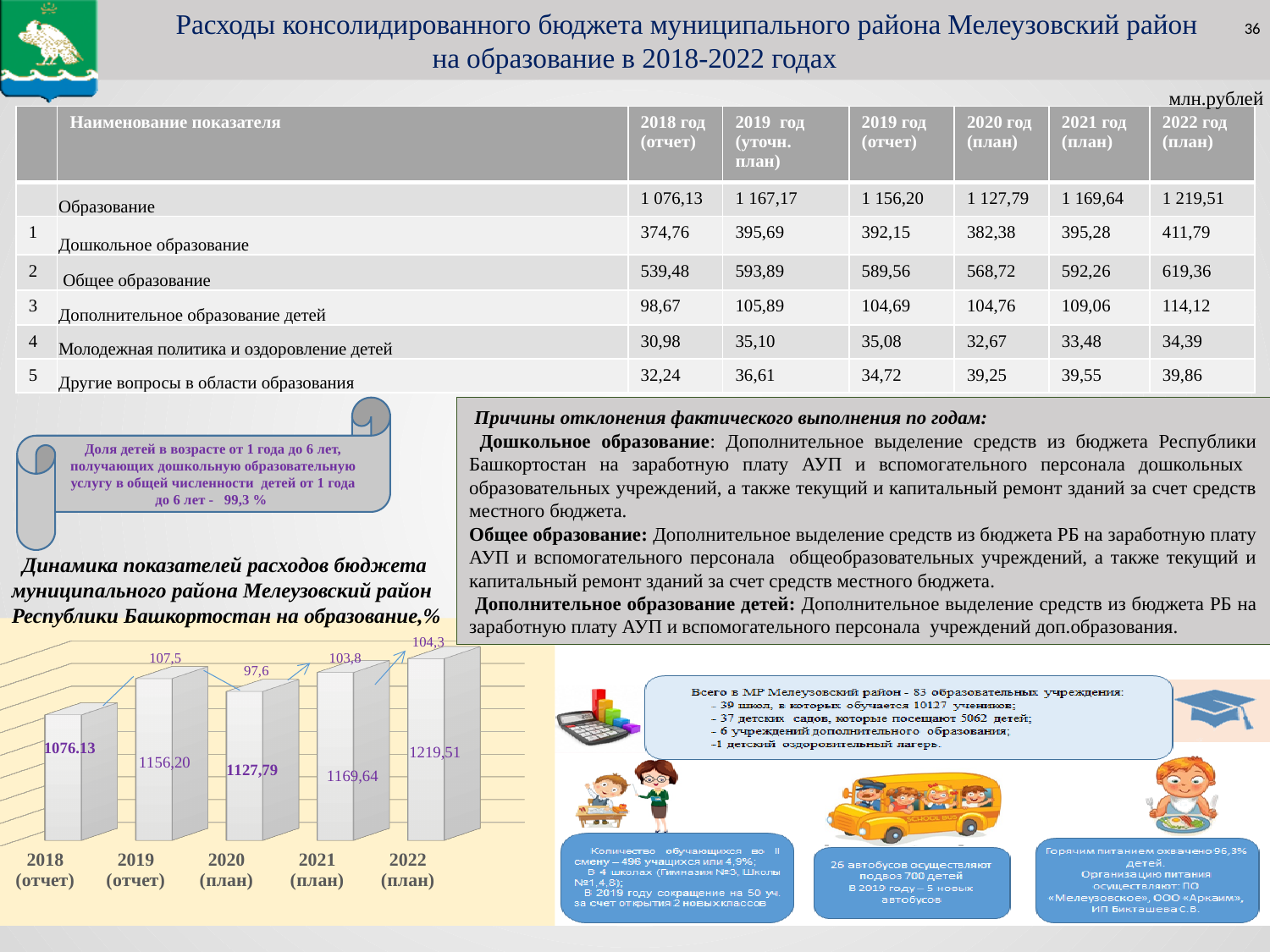
In the bar chart at the bottom left, what is the value for 2020 (план)? 1127,79 In the bar chart at the bottom left, which year has the highest value? 2022 (план) What type of chart is shown at the bottom left of the slide? bar chart In the bar chart at the bottom left, does the value rise or fall from 2019 (отчет) to 2020 (план)? fall In the bar chart at the bottom left, what is the difference between the values for 2021 (план) and 2020 (план)? 41,85 In the bar chart at the bottom left, what is the value for 2022 (план)? 1219,51 In the bar chart at the bottom left, what is the difference between the values for 2022 (план) and 2018 (отчет)? 143,38 How many bars are shown in the bar chart at the bottom left? 5 In the bar chart at the bottom left, which is larger: the value for 2019 (отчет) or the value for 2020 (план)? 2019 (отчет) In the bar chart at the bottom left, what is the value for 2018 (отчет)? 1076.13 In the bar chart at the bottom left, what is the value for 2019 (отчет)? 1156,20 In the bar chart at the bottom left, which year has the lowest value? 2018 (отчет)